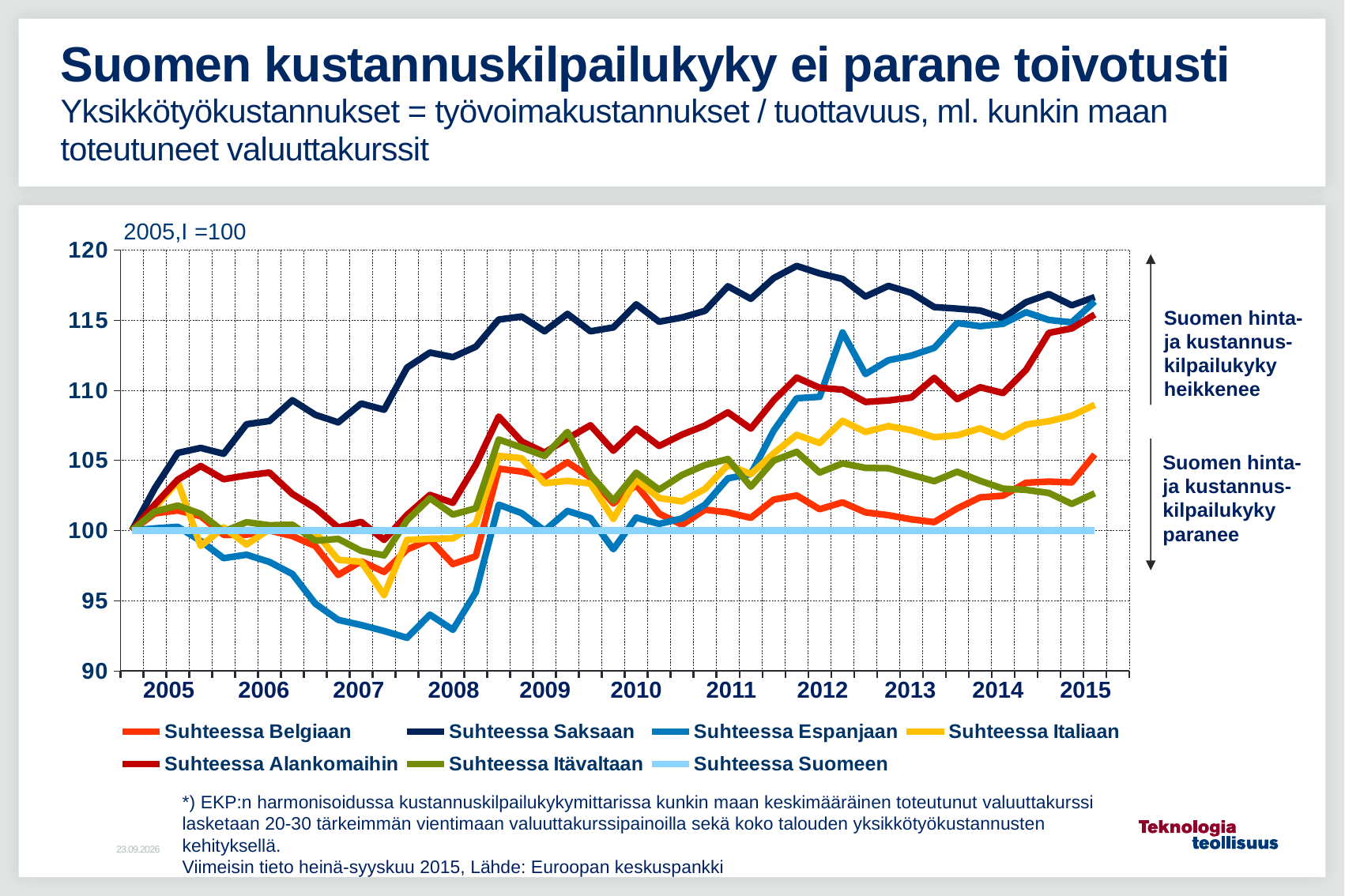
Is the value for Suhteessa Itävaltaan at the end of the series in 2015 greater or less than 105? less Is the value for Suhteessa Italiaan at the end of the series in 2015 greater or less than 105? greater How many series does the chart legend list? 7 Which series is the highest line on the chart during 2012? Suhteessa Saksaan Is the value for Suhteessa Saksaan in 2012 greater or less than 115? greater Which series is drawn as a flat line at 100 across the whole chart? Suhteessa Suomeen What kind of chart is shown on the slide? line chart Which series is the lowest line on the chart during 2007? Suhteessa Espanjaan At the end of the series in 2015, which is higher: Suhteessa Italiaan or Suhteessa Belgiaan? Suhteessa Italiaan What base index is stated above the chart? 2005,I =100 Does the Suhteessa Saksaan line rise or fall from 2005 to 2012? rise